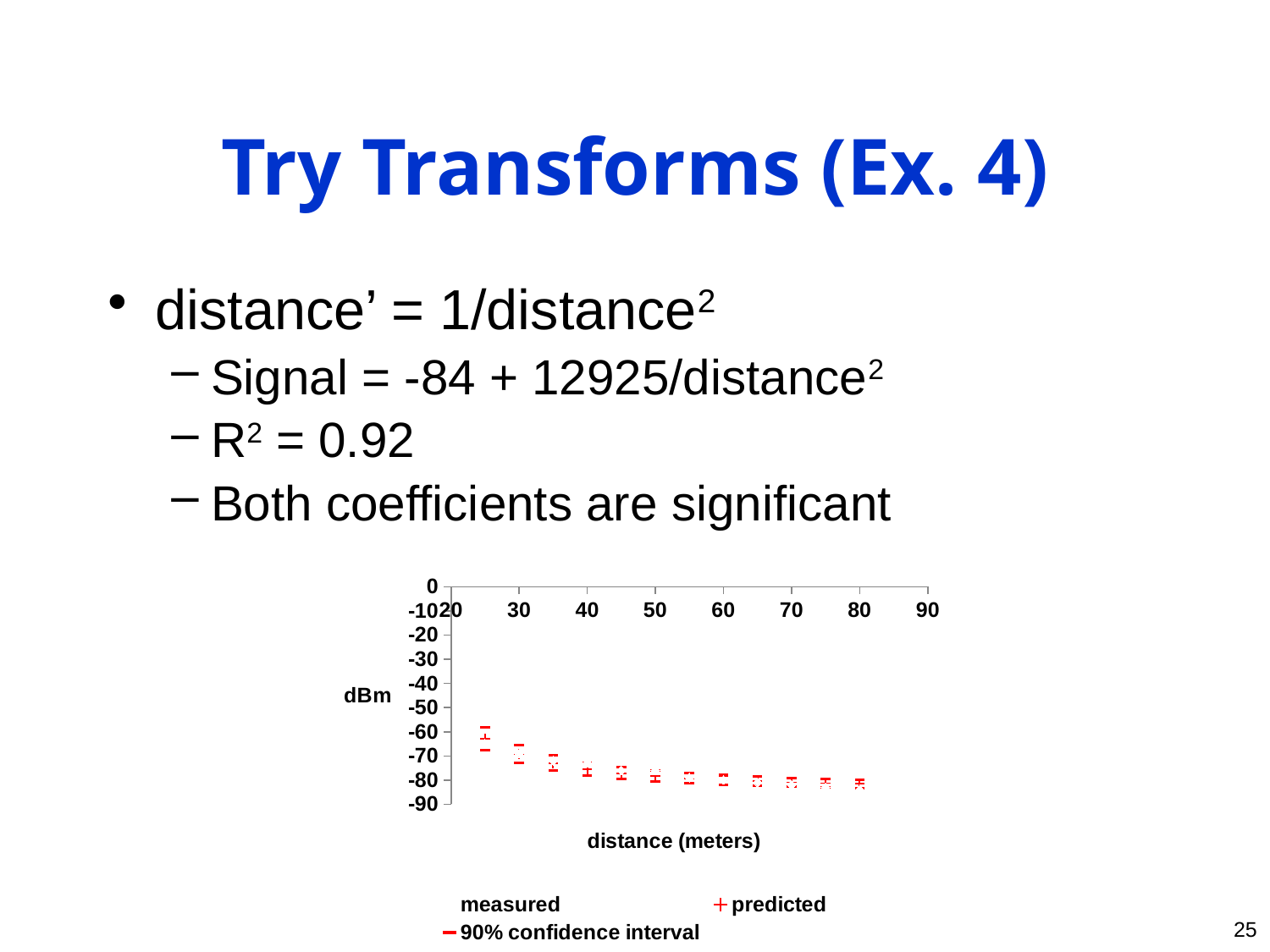
What is the title of the x axis of the chart? distance (meters) What is the lowest tick value shown on the y axis? -90 What label is shown on the y axis of the chart? dBm Is the measured value at about 80 meters greater or less than -70 dBm? less Is the measured value at about 25 meters greater or less than -50 dBm? less What kind of chart is shown on the slide? scatter chart Is the measured value at about 25 meters greater or less than -70 dBm? greater Do the plotted dBm values rise or fall as distance increases along the x axis? fall Which has the higher dBm value: the point at about 25 meters or the point at about 80 meters? the point at about 25 meters How many series does the chart legend list? 3